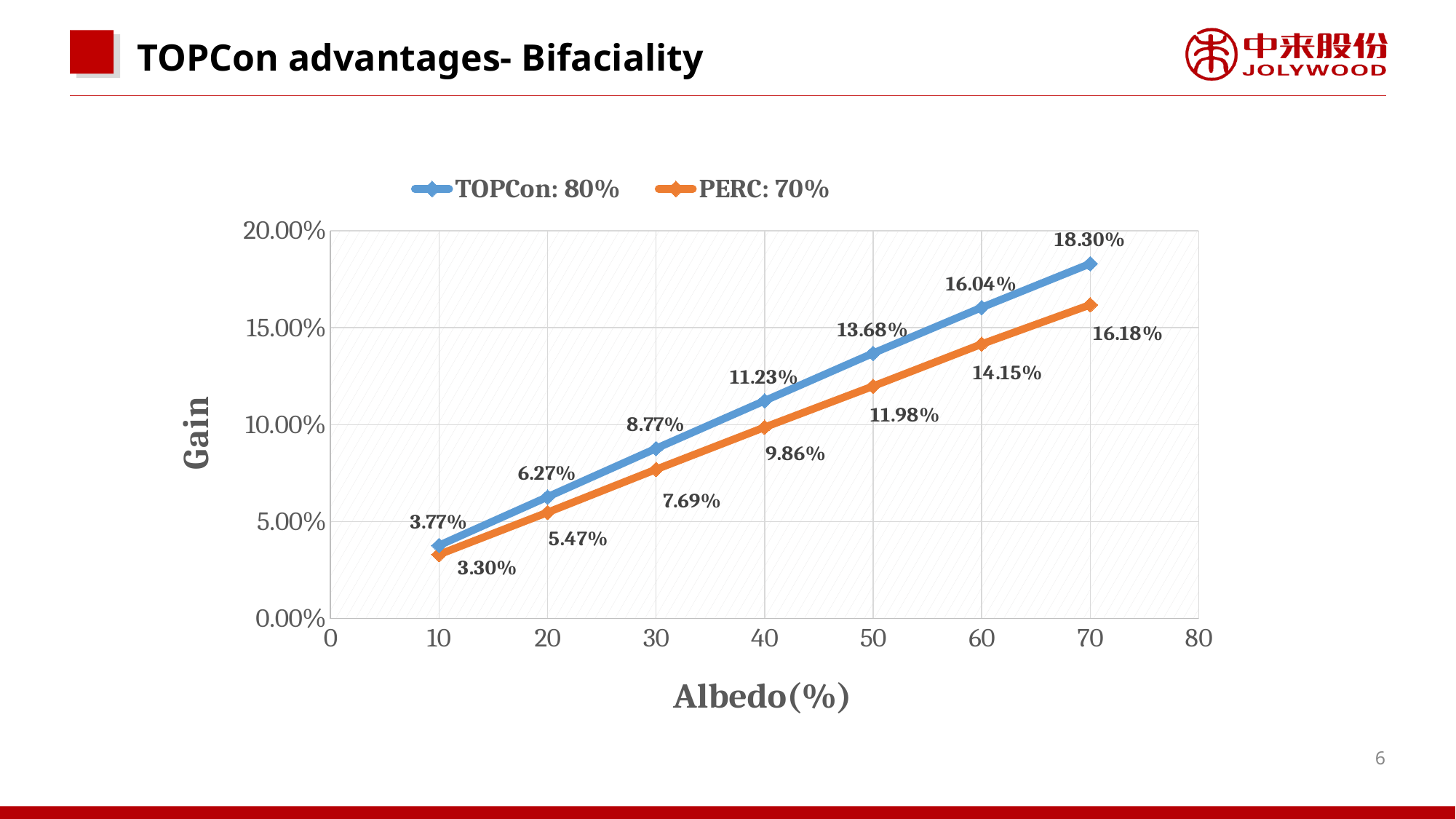
What is the difference between the TOPCon: 80% and PERC: 70% gains at an albedo of 70%? 2.12% At which albedo value is the TOPCon: 80% gain highest? 70 Do the gain values rise or fall as albedo increases? Rise Which series has the larger gain at an albedo of 50%, TOPCon: 80% or PERC: 70%? TOPCon: 80% What kind of chart is shown on the slide? Line chart How many data points are plotted for each series? 7 How many series does the legend list? 2 At which albedo value is the PERC: 70% gain lowest? 10 What is the gain for TOPCon: 80% at an albedo of 40%? 11.23% What is the gain for PERC: 70% at an albedo of 10%? 3.30% What is the gain for TOPCon: 80% at an albedo of 60%? 16.04% What is the gain for PERC: 70% at an albedo of 70%? 16.18%